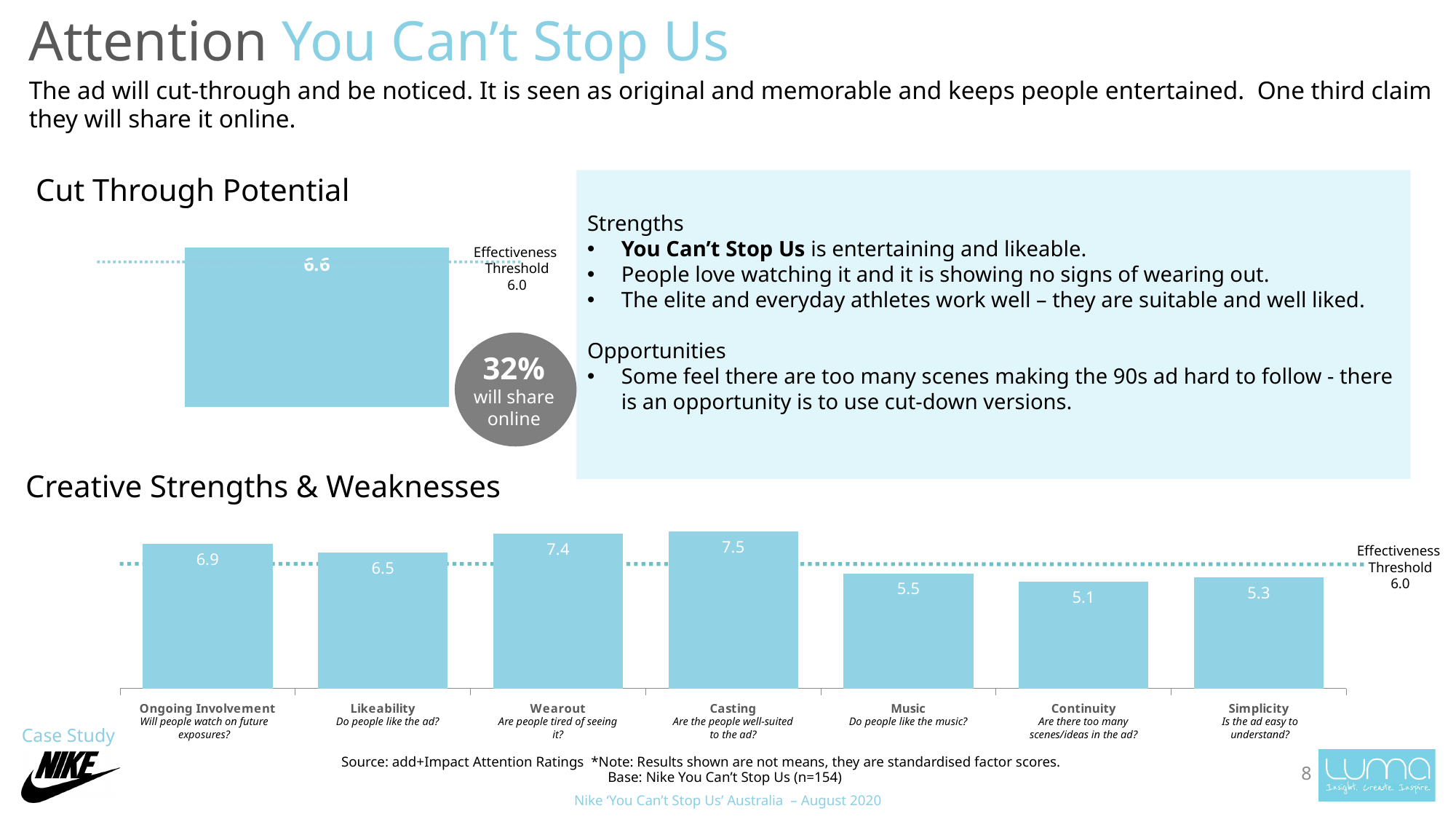
In the Creative Strengths & Weaknesses chart, which is larger, the value for Ongoing Involvement or the value for Simplicity? Ongoing Involvement What kind of chart is the Creative Strengths & Weaknesses chart? Bar chart In the Creative Strengths & Weaknesses chart, what is the value for Casting? 7.5 In the Creative Strengths & Weaknesses chart, which category has the lowest value? Continuity In the Creative Strengths & Weaknesses chart, which category has the highest value? Casting In the Creative Strengths & Weaknesses chart, how many categories fall below the Effectiveness Threshold of 6.0? 3 What value is the Effectiveness Threshold line set at in the Cut Through Potential chart? 6.0 In the Creative Strengths & Weaknesses chart, what is the value for Continuity? 5.1 In the Creative Strengths & Weaknesses chart, how many categories are shown? 7 In the Cut Through Potential chart, what value is shown on the bar? 6.6 In the Creative Strengths & Weaknesses chart, what is the value for Likeability? 6.5 In the Creative Strengths & Weaknesses chart, what is the difference between the values for Wearout and Music? 1.9